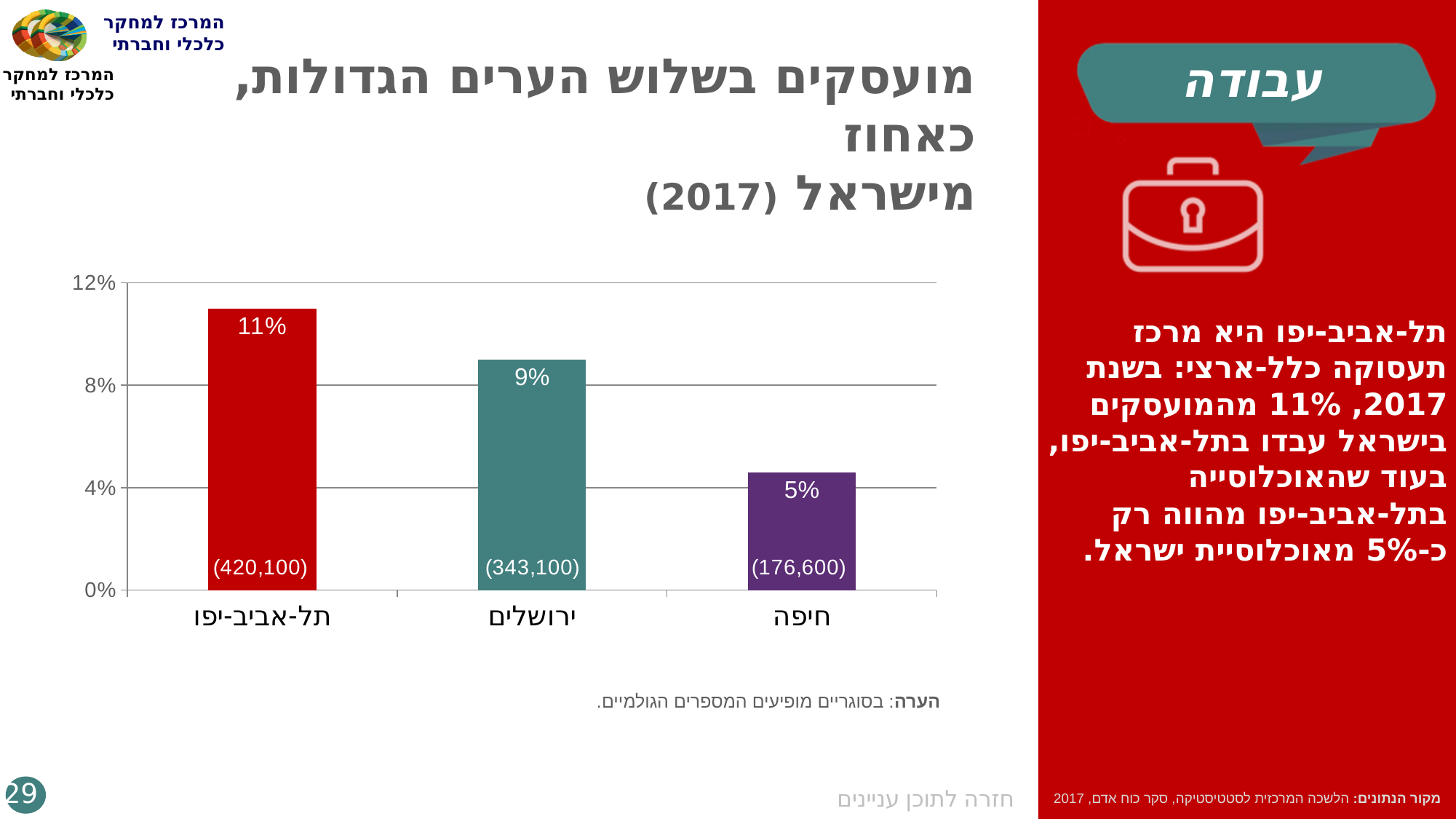
What absolute number is printed in parentheses on the bar for חיפה (Haifa)? (176,600) What percentage is shown for חיפה (Haifa)? 5% Which has a larger share, ירושלים (Jerusalem) or חיפה (Haifa)? ירושלים What absolute number is printed in parentheses on the bar for תל-אביב-יפו (Tel Aviv-Yafo)? (420,100) Which city has the lowest percentage of employed persons? חיפה How many cities are shown in the chart? 3 Which city has the highest percentage of employed persons? תל-אביב-יפו What is the difference in percentage points between תל-אביב-יפו (Tel Aviv-Yafo) and חיפה (Haifa)? 6% What percentage is shown for ירושלים (Jerusalem)? 9% What type of chart is shown on the slide? Bar chart What percentage is shown for תל-אביב-יפו (Tel Aviv-Yafo)? 11% Is the value for ירושלים (Jerusalem) greater or less than 8%? greater